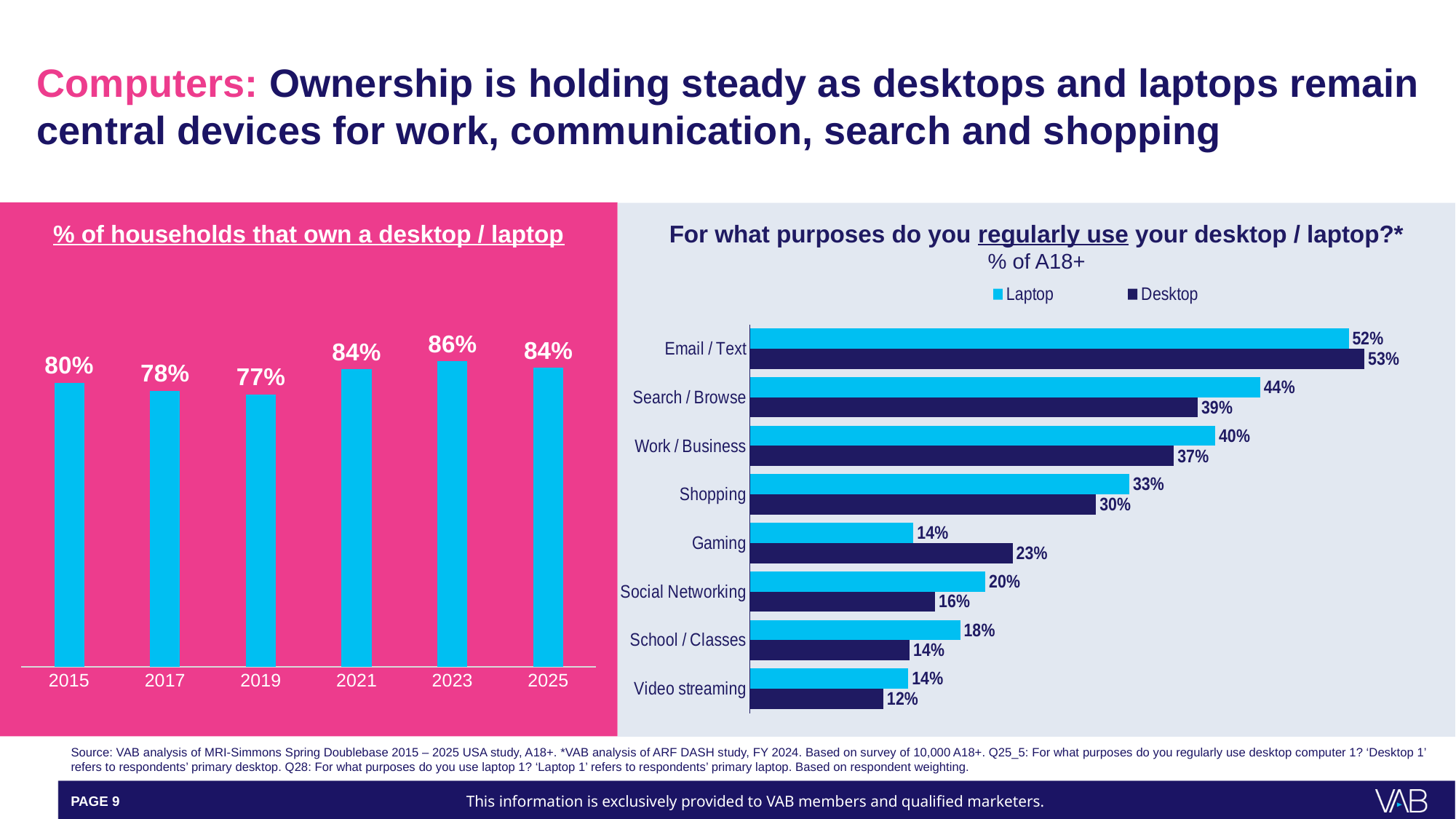
In the 'For what purposes do you regularly use your desktop / laptop?' chart, what is the Laptop value for Search / Browse? 44% In the '% of households that own a desktop / laptop' chart, what is the difference between the 2023 and 2019 values? 9 percentage points In the 'For what purposes do you regularly use your desktop / laptop?' chart, how many series does the legend list? 2 In the 'For what purposes do you regularly use your desktop / laptop?' chart, what is the Desktop value for Gaming? 23% In the 'For what purposes do you regularly use your desktop / laptop?' chart, which is larger for Gaming: Laptop or Desktop? Desktop What kind of chart is the '% of households that own a desktop / laptop' chart? Bar chart In the '% of households that own a desktop / laptop' chart, which year has the lowest value? 2019 In the '% of households that own a desktop / laptop' chart, what is the value for 2015? 80% In the '% of households that own a desktop / laptop' chart, which year has the highest value? 2023 In the 'For what purposes do you regularly use your desktop / laptop?' chart, which purpose has the highest Desktop value? Email / Text In the '% of households that own a desktop / laptop' chart, how many years are shown? 6 In the 'For what purposes do you regularly use your desktop / laptop?' chart, what is the difference between the Laptop and Desktop values for Shopping? 3 percentage points